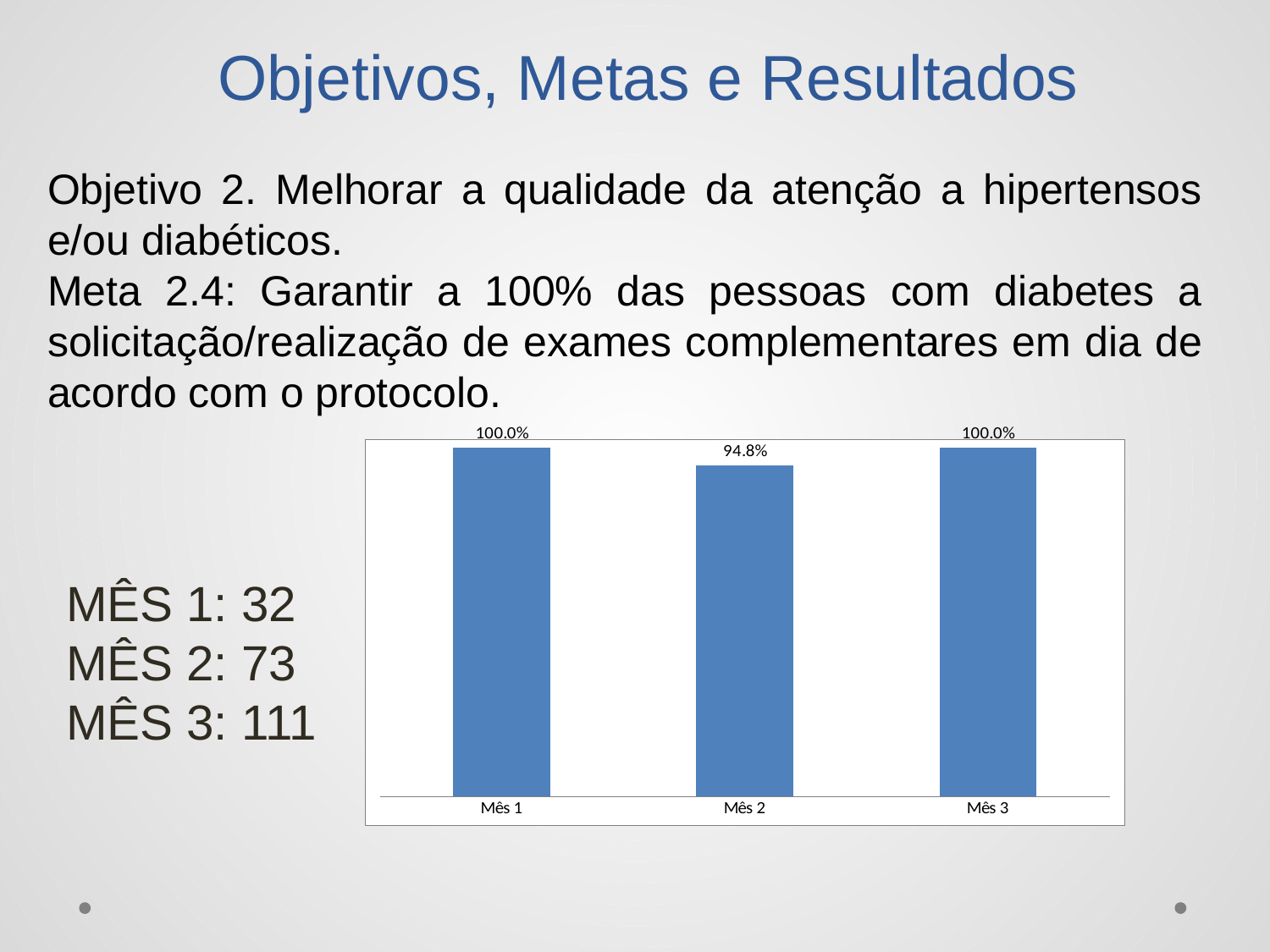
What is the value for Mês 1? 100.0% Which month has the lowest value? Mês 2 Do the values rise or fall from Mês 2 to Mês 3? rise What is the value for Mês 3? 100.0% How many categories are shown on the x axis? 3 Are the bars in the chart vertical or horizontal? vertical What kind of chart is shown on the slide? bar chart Do the values rise or fall from Mês 1 to Mês 2? fall What colour are the bars in the chart? blue What is the difference between the values for Mês 1 and Mês 2? 5.2% What is the value for Mês 2? 94.8% Which is larger, the value for Mês 2 or the value for Mês 3? Mês 3